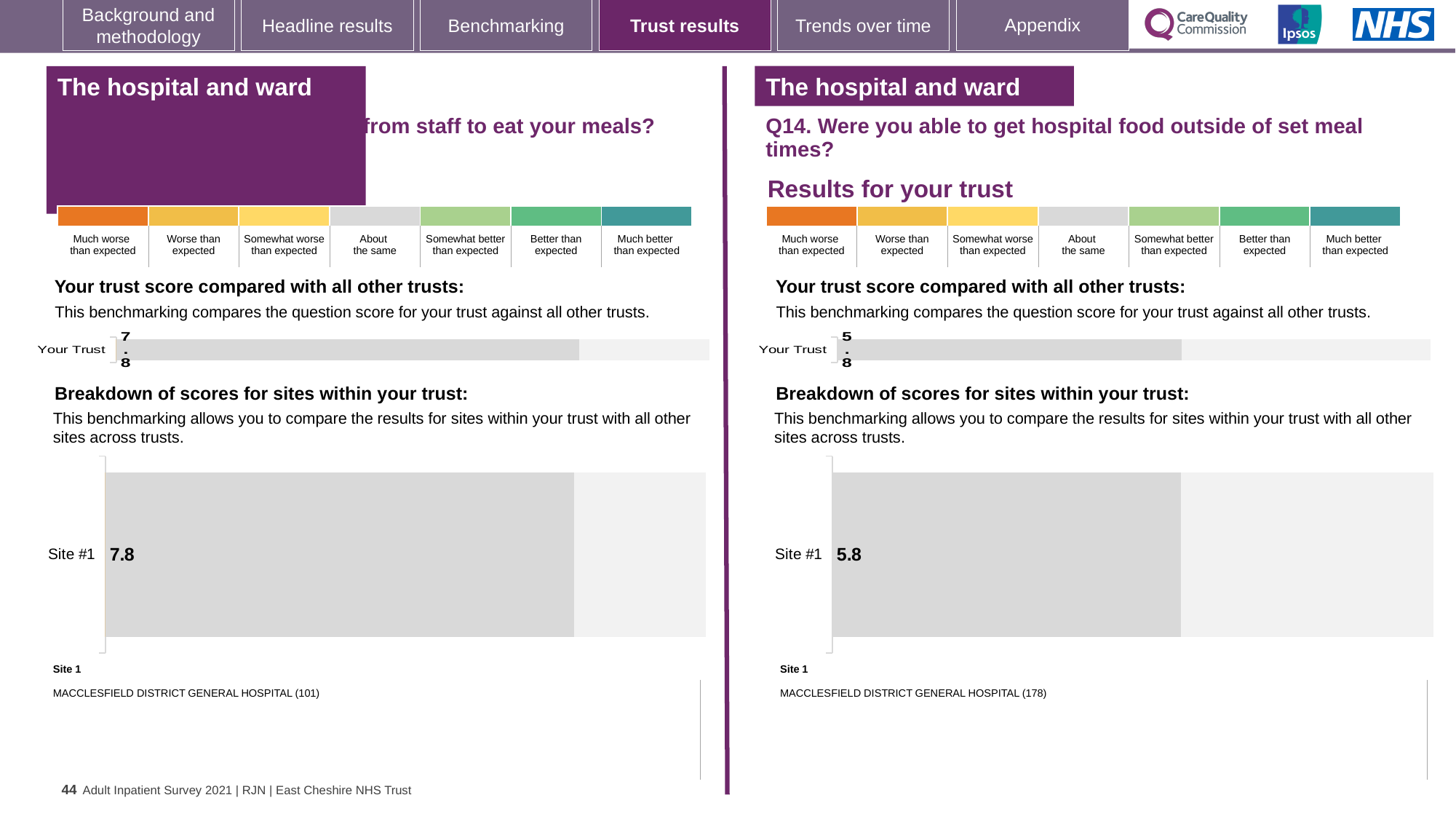
On the left-hand chart, what is the score shown for Your Trust? 7.8 On the right-hand chart for Q14, what is the score shown for Your Trust? 5.8 Which hospital is listed as Site 1 beneath the right-hand Q14 chart? Macclesfield District General Hospital (178) In the left-hand site breakdown chart, what is the score for Site #1? 7.8 How many sites are shown in the right-hand Q14 site breakdown chart? 1 Which is larger: the Your Trust score on the left-hand chart or the Your Trust score on the right-hand Q14 chart? The left-hand chart (7.8) How many categories does the colour key above the right-hand Q14 chart show, from 'Much worse than expected' to 'Much better than expected'? 7 What is the difference between the Site #1 score on the left-hand chart and the Site #1 score on the right-hand Q14 chart? 2.0 What type of chart is used to show the Site #1 score on the right-hand side of the slide? Bar chart In the right-hand site breakdown chart for Q14, what is the score for Site #1? 5.8 How many sites are shown in the left-hand site breakdown chart? 1